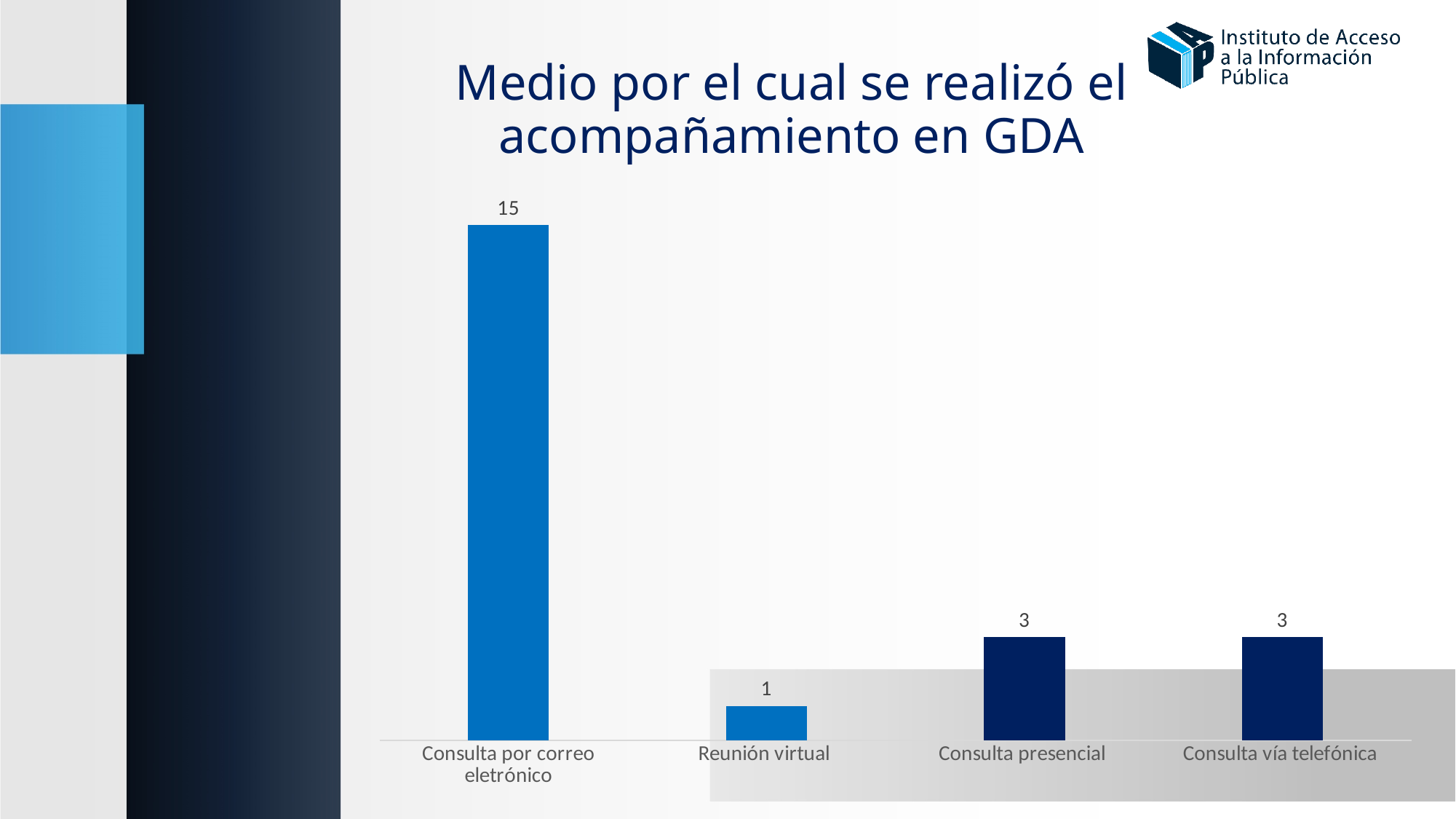
What is the difference between the values for Consulta por correo eletrónico and Consulta presencial? 12 What is the value for Consulta vía telefónica? 3 Which category has the highest value? Consulta por correo eletrónico What is the value for Consulta por correo eletrónico? 15 What is the value for Consulta presencial? 3 What is the difference between the values for Consulta presencial and Reunión virtual? 2 What is the value for Reunión virtual? 1 What is the title of the chart on the slide? Medio por el cual se realizó el acompañamiento en GDA Which is larger, the value for Consulta vía telefónica or the value for Reunión virtual? Consulta vía telefónica How many categories are shown in the chart? 4 Which category has the lowest value? Reunión virtual What kind of chart is shown on the slide? Bar chart